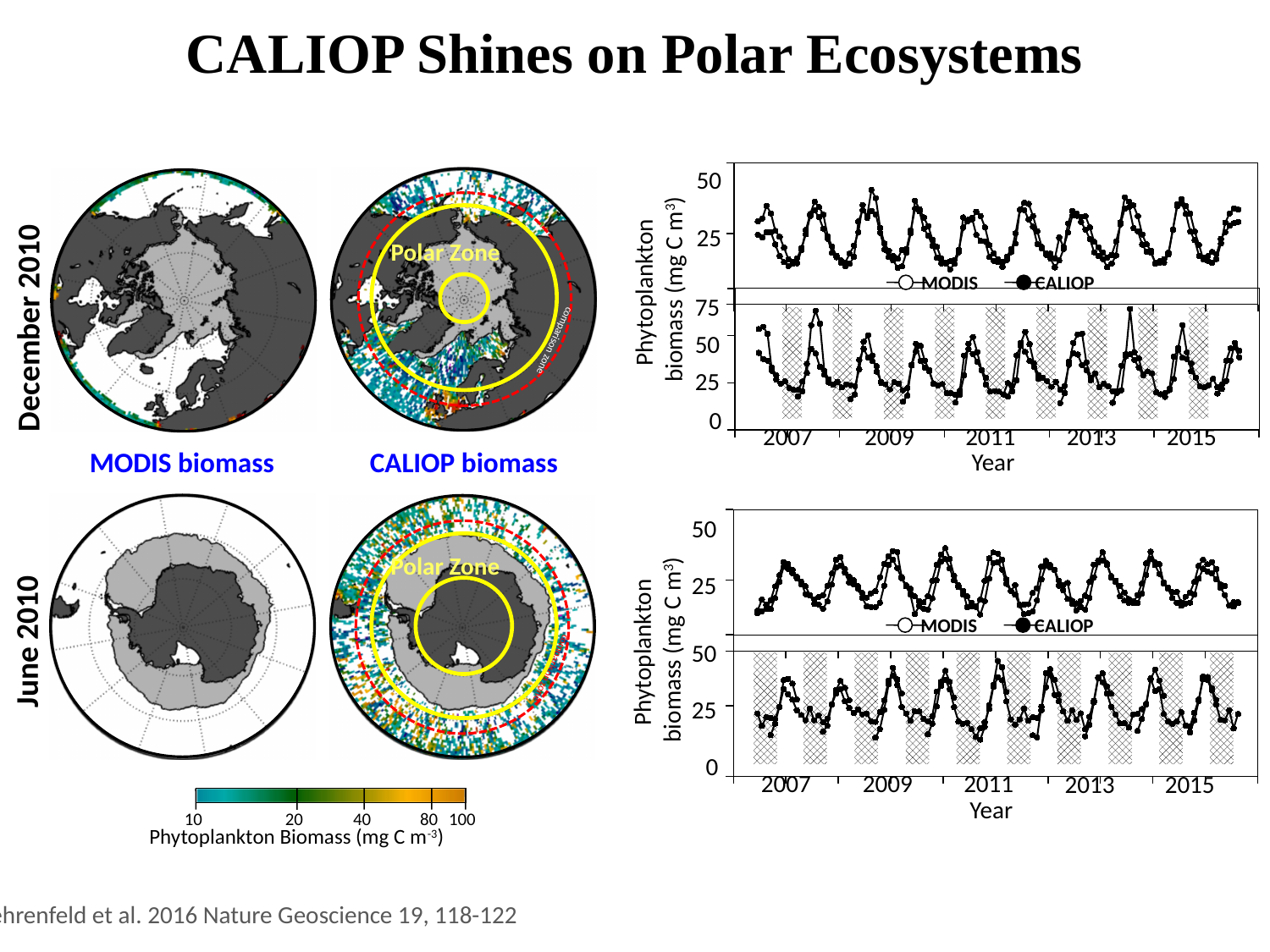
In the upper panel of the bottom-right chart, are the lowest values each year greater or less than 25? less What kind of chart is the top-right chart (the one above the 'Year' axis at the top)? line chart How many series does the legend of the top-right chart list? 2 What is the first year label on the x axis of the bottom-right chart? 2007 How many year labels are printed on the x axis of the top-right chart? 5 What is the y-axis label of the bottom-right chart? Phytoplankton biomass (mg C m⁻³) What are the two series named in the legend of the bottom-right chart? MODIS and CALIOP Along the x axis of the bottom-right chart, do the values rise steadily, fall steadily, or oscillate up and down each year? oscillate up and down each year In the upper panel of the top-right chart, are the peak values greater or less than 50? less In the lower panel of the top-right chart, is the peak value in 2013 greater or less than 50? greater What is the last year label on the x axis of the top-right chart? 2015